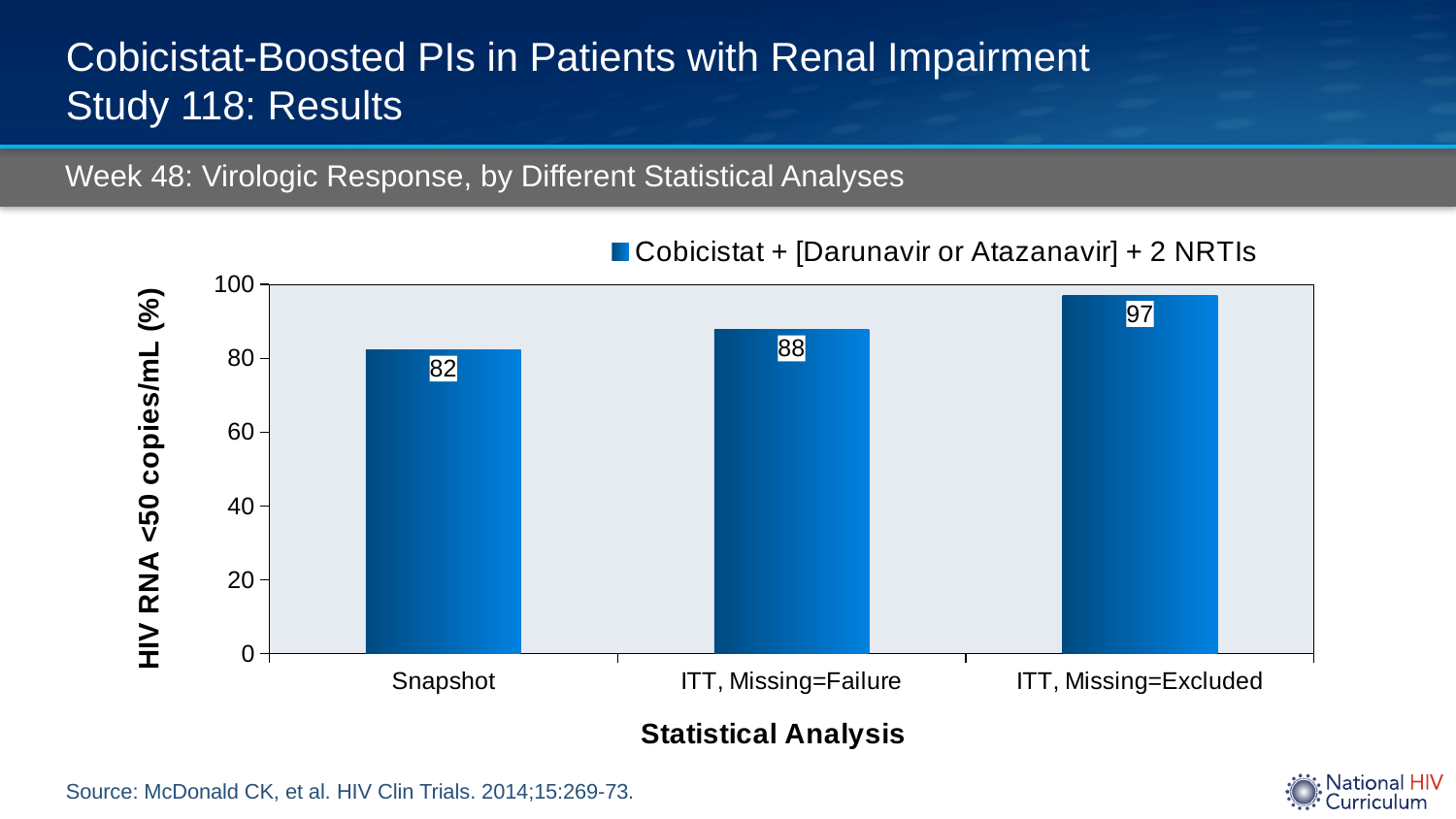
Is the value for Snapshot greater or less than 80? greater What is the value for Snapshot? 82 What kind of chart is shown on the slide? Bar chart Which statistical analysis has the highest value? ITT, Missing=Excluded What is the value for ITT, Missing=Failure? 88 Which statistical analysis has the lowest value? Snapshot How many statistical analysis categories are shown on the x axis? 3 What is the value for ITT, Missing=Excluded? 97 What series does the legend list? Cobicistat + [Darunavir or Atazanavir] + 2 NRTIs What is the difference between the values for ITT, Missing=Failure and Snapshot? 6 What is the difference between the values for ITT, Missing=Excluded and Snapshot? 15 Which is larger, the value for Snapshot or the value for ITT, Missing=Failure? ITT, Missing=Failure